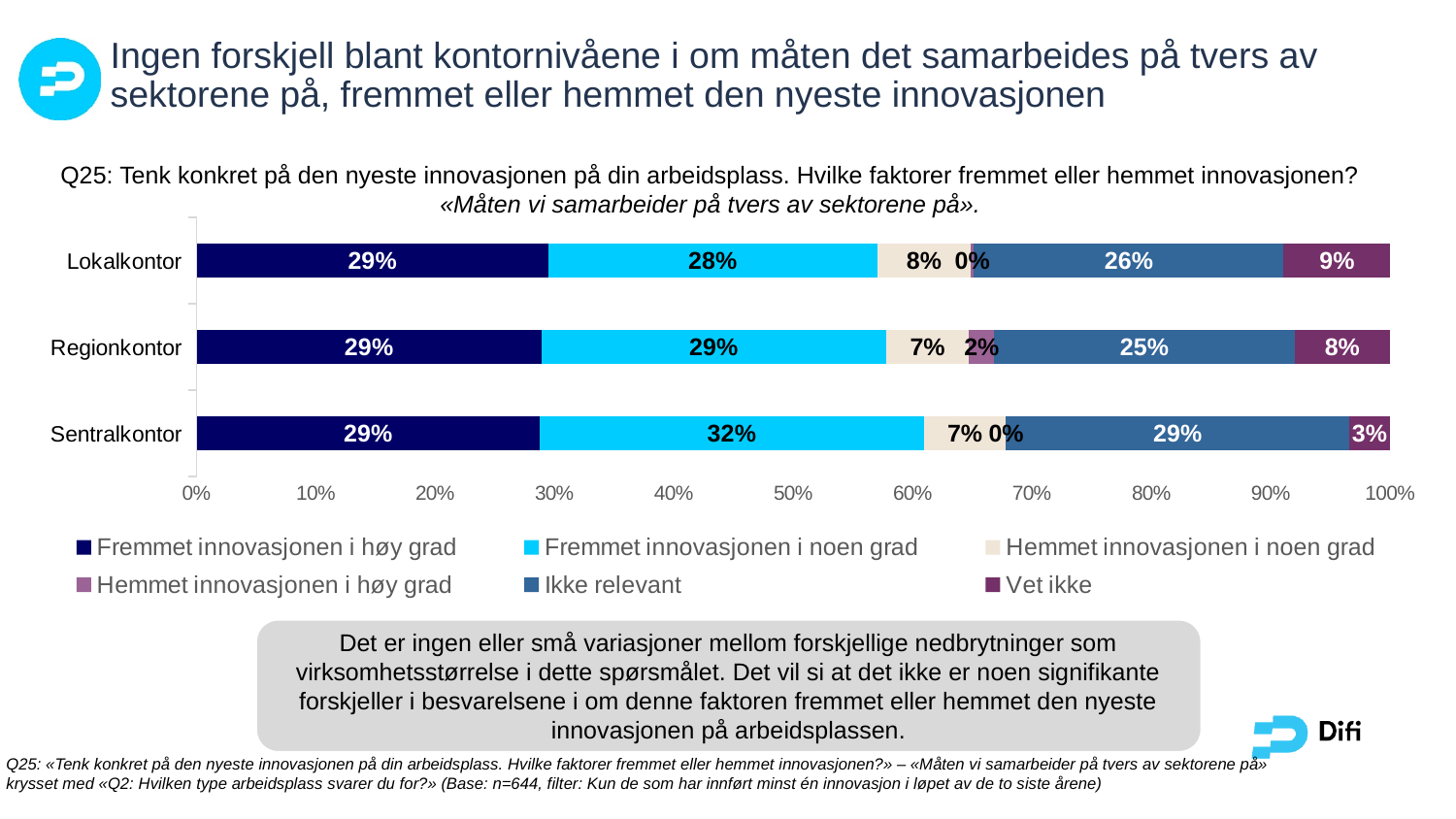
What is the value for 'Ikke relevant' for Regionkontor? 25% Which category has the highest value for 'Fremmet innovasjonen i noen grad'? Sentralkontor How many series does the chart's legend list? 6 What is the value for 'Hemmet innovasjonen i høy grad' for Regionkontor? 2% What is the difference between the 'Fremmet innovasjonen i noen grad' values for Sentralkontor and Lokalkontor? 4 percentage points What kind of chart is shown on the slide? Stacked bar chart How many categories (office levels) are shown on the y axis of the chart? 3 Which category has the lowest value for 'Vet ikke'? Sentralkontor What is the value for 'Fremmet innovasjonen i noen grad' for Sentralkontor? 32% What is the value for 'Vet ikke' for Lokalkontor? 9% Which is larger: the 'Ikke relevant' value for Sentralkontor or for Regionkontor? Sentralkontor Which legend entry is shown in the darkest navy colour, at the left end of each bar? Fremmet innovasjonen i høy grad